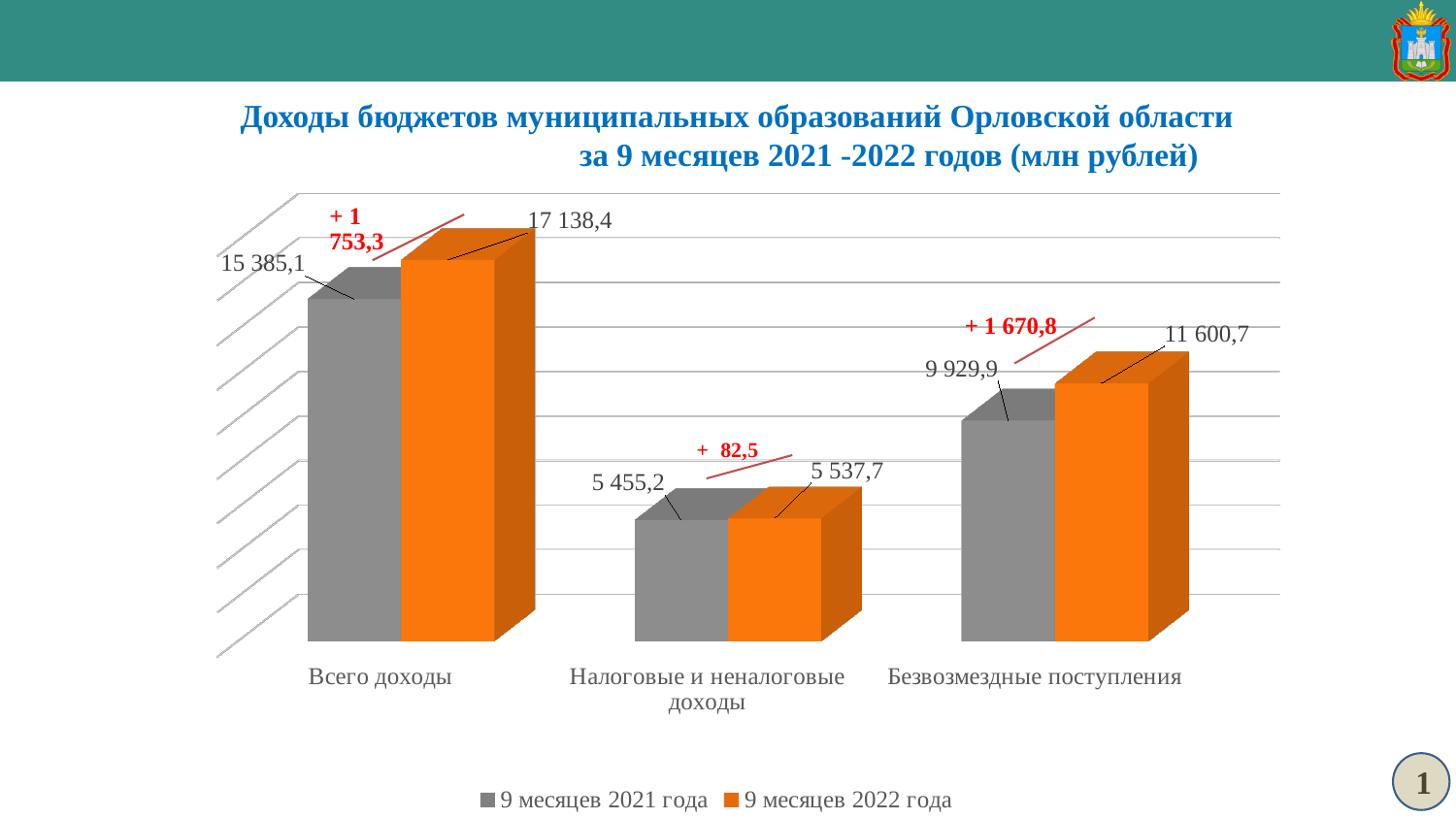
What is the value for Всего доходы in the 9 месяцев 2022 года series? 17 138,4 How many series does the legend list? 2 What is the difference between the 2022 and 2021 values for Налоговые и неналоговые доходы? 82,5 Which is larger for Всего доходы: the 9 месяцев 2021 года value or the 9 месяцев 2022 года value? 9 месяцев 2022 года What kind of chart is shown on the slide? Bar chart What is the value for Всего доходы in the 9 месяцев 2021 года series? 15 385,1 Which category has the lowest value in the 9 месяцев 2021 года series? Налоговые и неналоговые доходы What is the value for Налоговые и неналоговые доходы in the 9 месяцев 2021 года series? 5 455,2 Which category has the highest value in the 9 месяцев 2022 года series? Всего доходы What is the value for Безвозмездные поступления in the 9 месяцев 2022 года series? 11 600,7 How many categories are shown on the x axis? 3 What is the difference between the 2022 and 2021 values for Безвозмездные поступления? 1 670,8